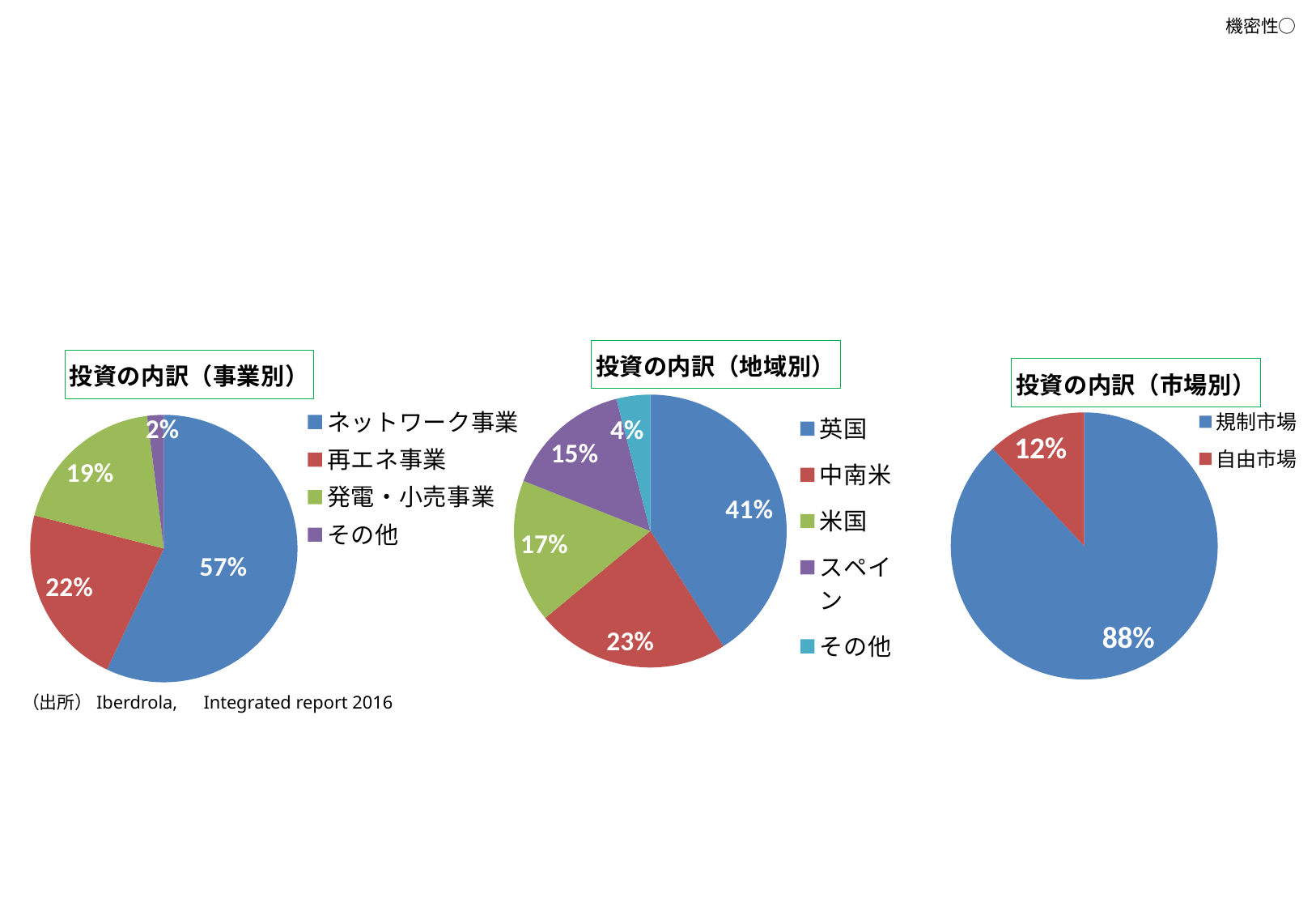
In the 投資の内訳（事業別） chart, what share does ネットワーク事業 have? 57% In the 投資の内訳（市場別） chart, what is the difference between 規制市場 and 自由市場? 76% How many categories does the 投資の内訳（事業別） chart show? 4 How many categories does the 投資の内訳（地域別） chart show? 5 In the 投資の内訳（事業別） chart, what is the difference between the shares of 再エネ事業 and 発電・小売事業? 3% How many charts are on the slide? 3 In the 投資の内訳（地域別） chart, which region has the largest share? 英国 In the 投資の内訳（地域別） chart, what share does 中南米 have? 23% What kind of chart is the 投資の内訳（市場別） chart? Pie chart In the 投資の内訳（地域別） chart, which is larger, 米国 or スペイン? 米国 In the 投資の内訳（市場別） chart, what share does 自由市場 have? 12% In the 投資の内訳（事業別） chart, which category has the smallest share? その他